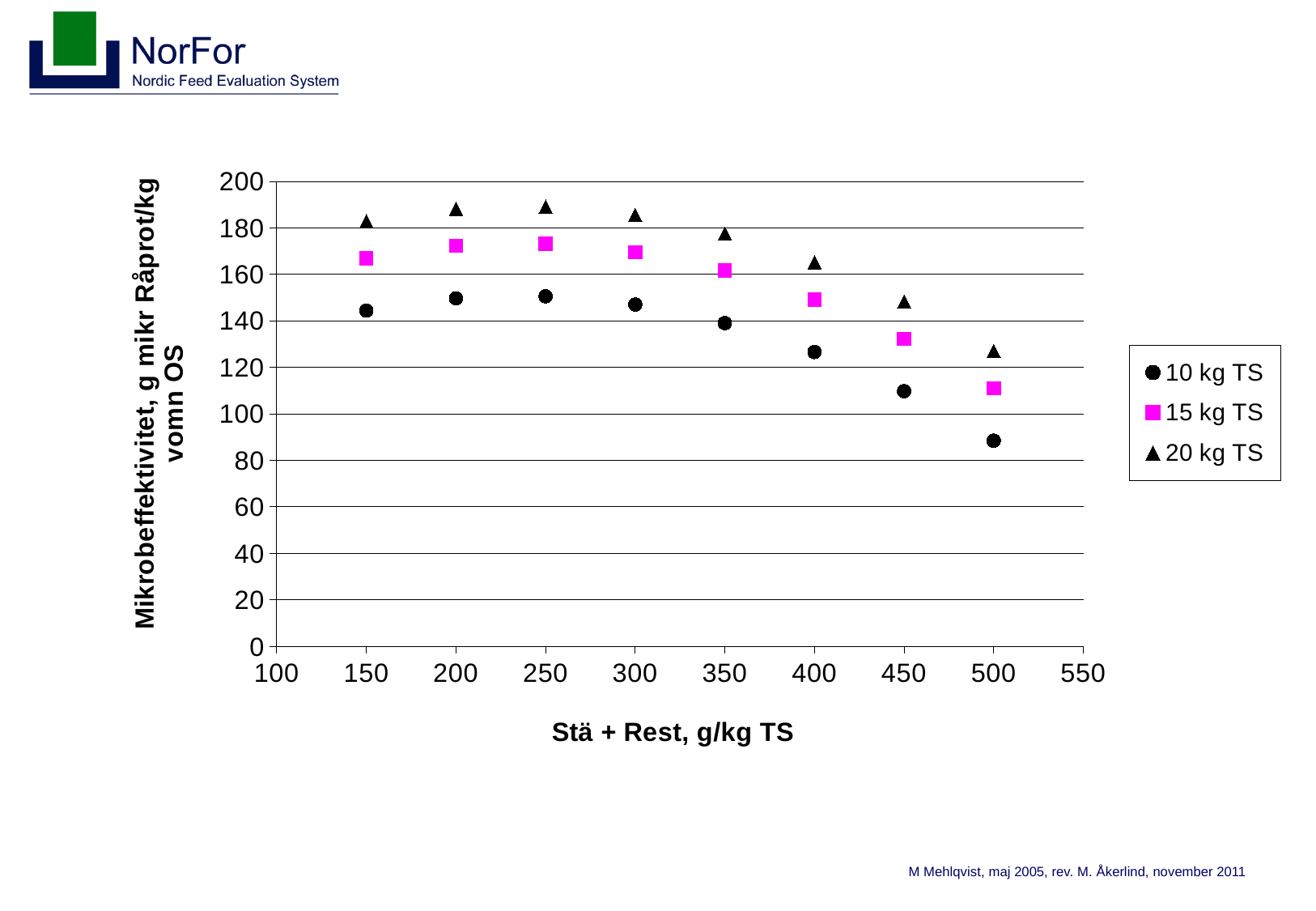
Is the value for 20 kg TS at Stä + Rest 500 greater or less than 120? greater How many series does the legend list? 3 Is the value for 20 kg TS at Stä + Rest 250 greater or less than 180? greater Is the value for 10 kg TS at Stä + Rest 400 greater or less than 140? less At which Stä + Rest value is the 10 kg TS series lowest? 500 At Stä + Rest 300, which series has the larger value, 10 kg TS or 20 kg TS? 20 kg TS How many data points are plotted for the 10 kg TS series? 8 Do the 15 kg TS values rise or fall as Stä + Rest increases from 300 to 500? fall What is the title of the x axis? Stä + Rest, g/kg TS What kind of chart is shown on the slide? scatter chart